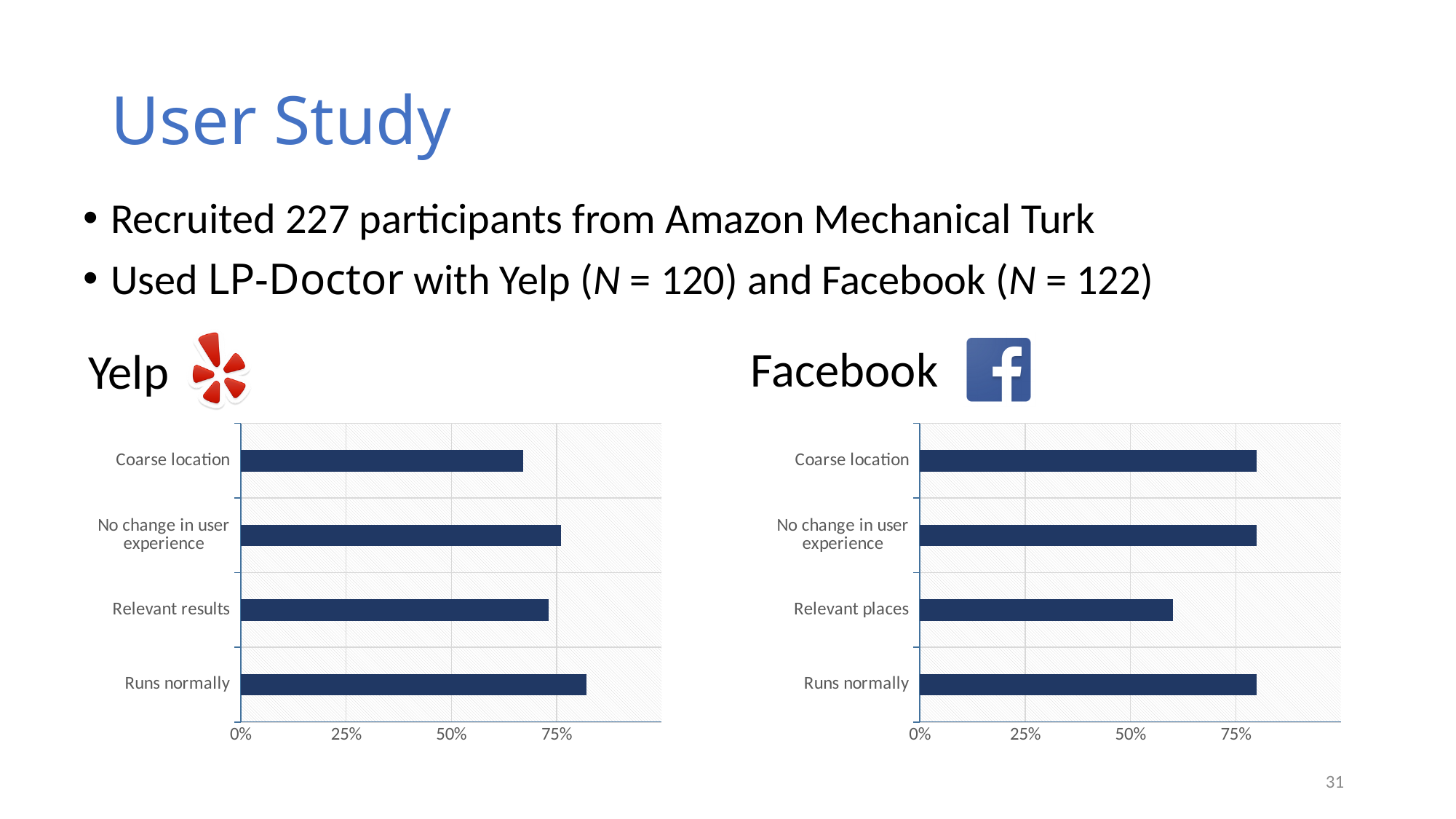
In the Yelp chart, is the value for Runs normally greater or less than 75%? greater In the Yelp chart, which category has the lowest value? Coarse location In the Facebook chart, is the value for Relevant places greater or less than 50%? greater What kind of chart is the Yelp chart? bar chart In the Facebook chart, which category has the lowest value? Relevant places In the Yelp chart, is the value for Coarse location greater or less than 75%? less In the Facebook chart, which is larger: Coarse location or Relevant places? Coarse location In the Yelp chart, which category has the highest value? Runs normally In the Yelp chart, which is larger: Runs normally or Coarse location? Runs normally How many categories does the Facebook chart show? 4